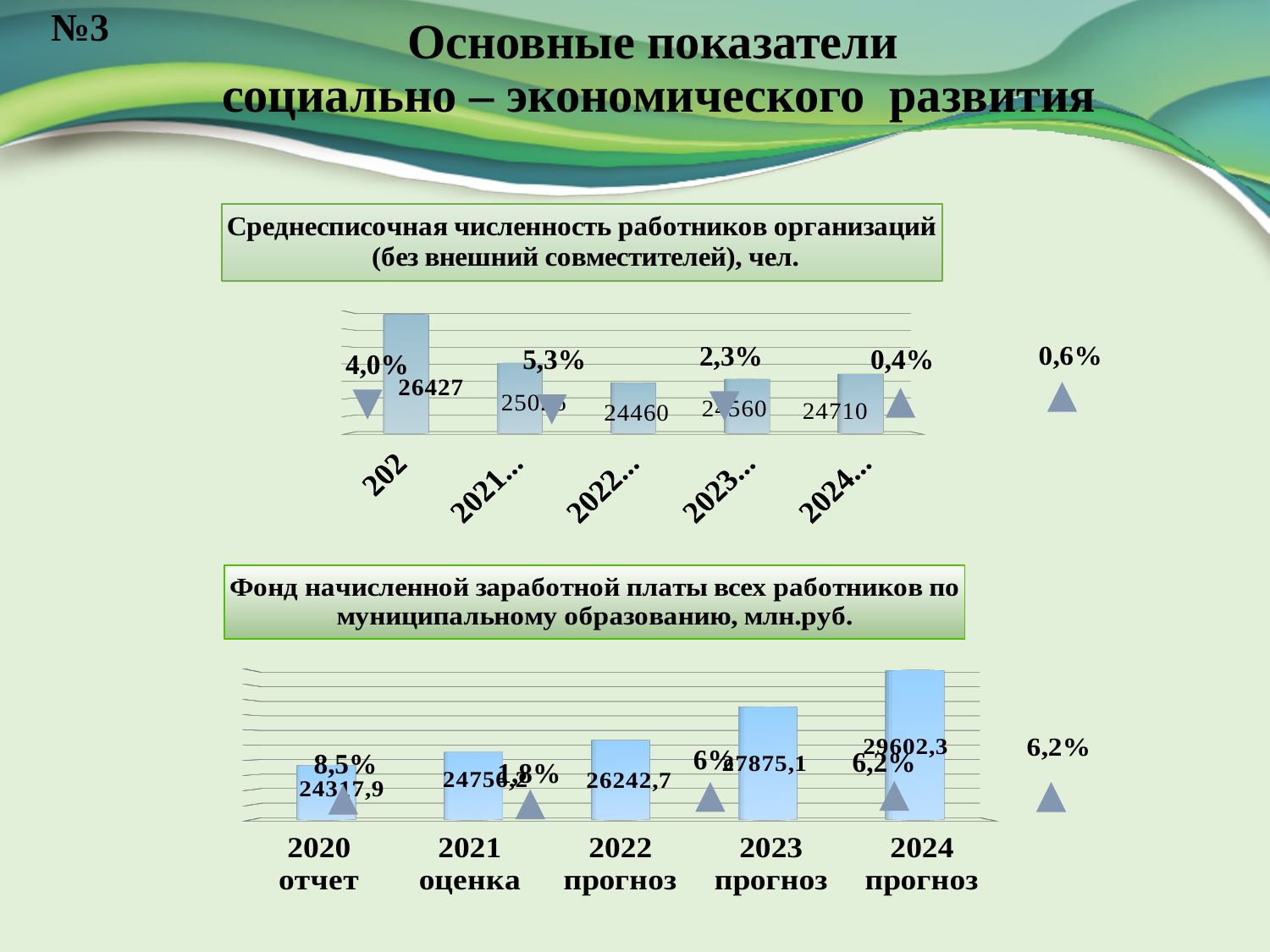
On the bottom chart (Фонд начисленной заработной платы), which category has the lowest value? 2020 отчет How many categories are shown on the bottom chart (Фонд начисленной заработной платы)? 5 On the top chart (Среднесписочная численность работников), what is the value for 2024? 24710 On the top chart (Среднесписочная численность работников), what is the difference between the 2020 value and the 2024 value? 1717 What kind of chart is the top chart (Среднесписочная численность работников)? bar chart On the bottom chart (Фонд начисленной заработной платы), what is the difference between the 2024 прогноз and 2023 прогноз values? 1727,2 On the bottom chart (Фонд начисленной заработной платы), what is the value for 2022 прогноз? 26242,7 On the bottom chart (Фонд начисленной заработной платы), what is the value for 2020 отчет? 24317,9 On the top chart (Среднесписочная численность работников), which category has the highest value? 2020 On the bottom chart (Фонд начисленной заработной платы), what is the value for 2024 прогноз? 29602,3 On the bottom chart (Фонд начисленной заработной платы), which category has the highest value? 2024 прогноз On the bottom chart (Фонд начисленной заработной платы), do the values rise or fall from 2020 to 2024? rise